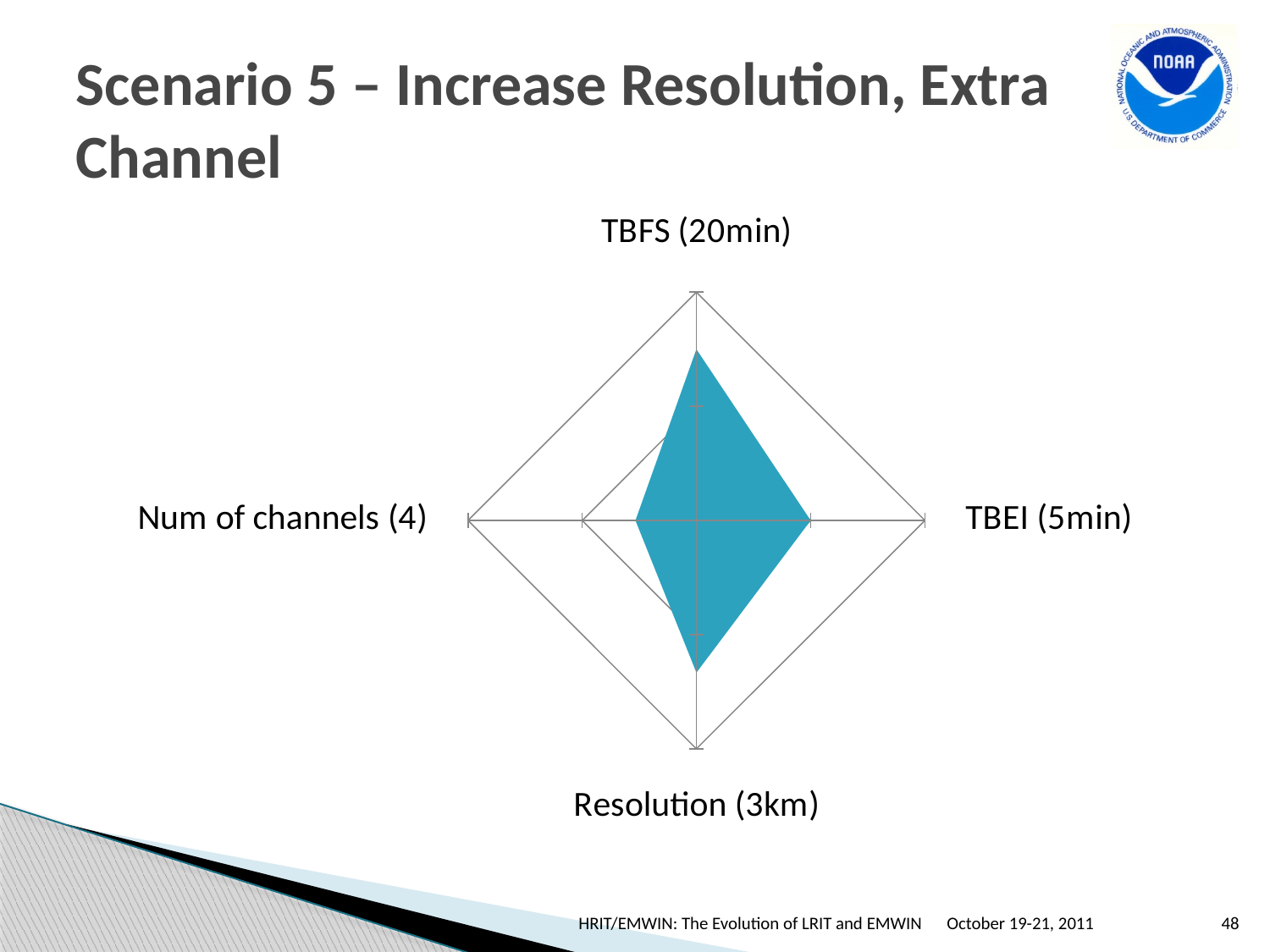
How many axes (categories) does the radar chart have? 4 Which category label appears at the top of the radar chart? TBFS (20min) Which is larger on the radar chart, the value for Resolution (3km) or the value for Num of channels (4)? Resolution (3km) Which category has the lowest value on the radar chart? Num of channels (4) Which is larger on the radar chart, the value for TBEI (5min) or the value for Num of channels (4)? TBEI (5min) Which is larger on the radar chart, the value for TBFS (20min) or the value for TBEI (5min)? TBFS (20min) Which category has the highest value on the radar chart? TBFS (20min) What kind of chart is shown on the slide? Radar chart Which category label appears at the bottom of the radar chart? Resolution (3km)